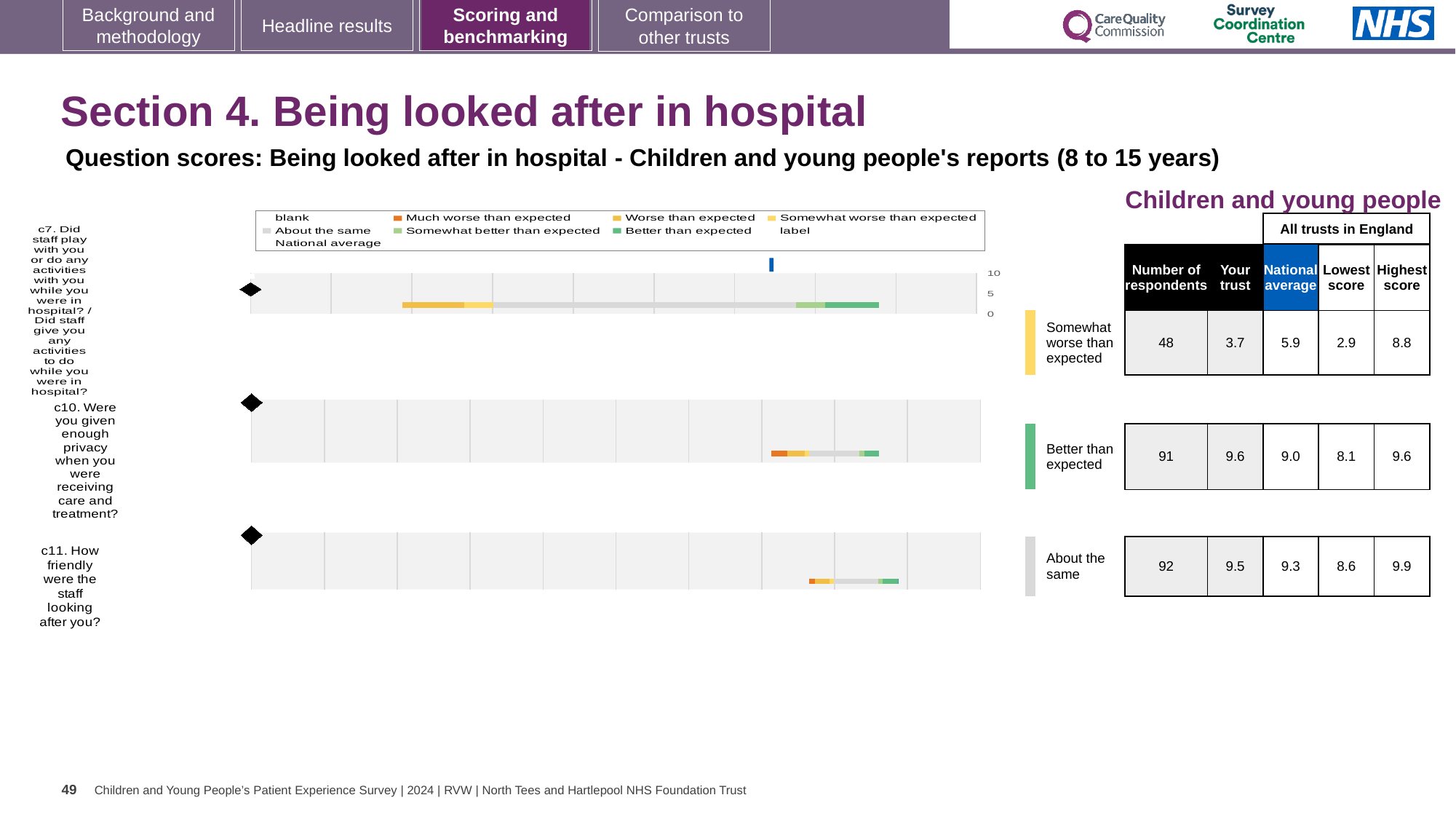
Which question has the highest 'Your trust' score? c10 What is the national average score for question c10 (Were you given enough privacy when you were receiving care and treatment?)? 9.0 Which benchmark category is question c7 placed in? Somewhat worse than expected Which benchmark category is question c10 placed in? Better than expected What is the 'Your trust' score for question c7 (Did staff play with you or do any activities with you while you were in hospital?)? 3.7 For question c11 (How friendly were the staff looking after you?), which is larger: the trust's score or the national average? Your trust (9.5) What is the highest score among all trusts in England for question c7? 8.8 How many respondents answered question c11? 92 For question c7, how much higher is the national average than the trust's score? 2.2 What kind of chart is used to show the question scores on this slide? Bar chart Which question has the lowest 'Your trust' score? c7 How many questions (categories) are plotted in the chart? 3